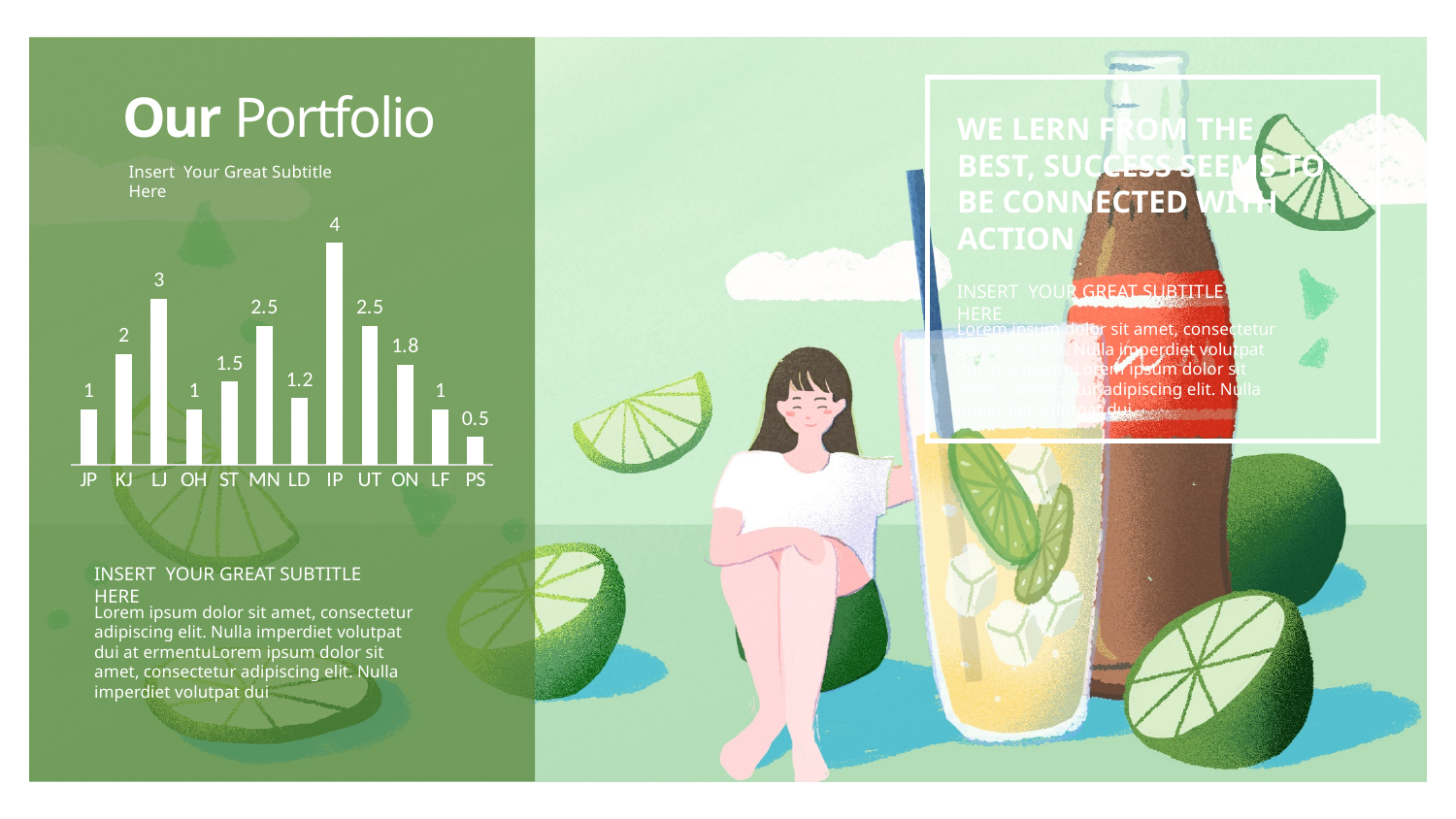
What is the value for IP? 4 Which category has the highest value? IP What is the value for ON? 1.8 Which category has the lowest value? PS What kind of chart is shown on the slide? bar chart What is the value for ST? 1.5 What is the difference between the values for IP and LJ? 1 What colour are the bars in the chart? white How many categories are shown on the x axis of the chart? 12 Which is larger, the value for KJ or the value for ON? KJ What is the difference between the values for MN and LD? 1.3 What is the value for LD? 1.2